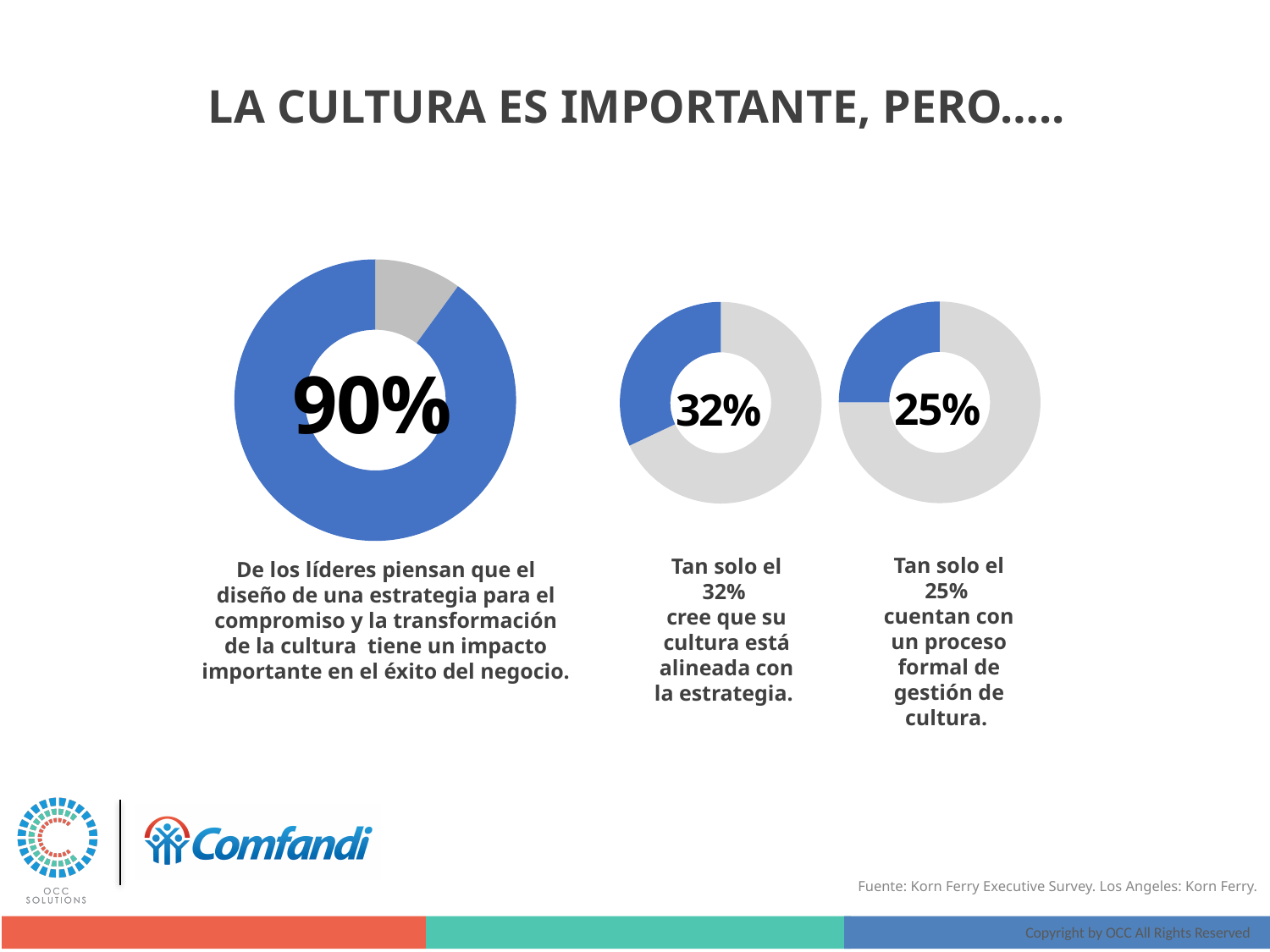
Which of the three donut charts shows the highest percentage? the left chart (90%) Which is larger: the percentage in the middle chart or the percentage in the right chart? the middle chart (32%) What is the difference between the percentage in the left chart (90%) and the percentage in the middle chart (32%)? 58 percentage points Which of the three donut charts shows the lowest percentage? the right chart (25%) What colour is used for the highlighted percentage slice in each donut chart? blue In the middle chart, what percentage believe their culture is aligned with the strategy? 32% In the left chart, what percentage of leaders think that designing a strategy for engagement and culture transformation has an important impact on business success? 90% What is the difference between the percentage in the middle chart (32%) and the percentage in the right chart (25%)? 7 percentage points In the left chart, what share of the donut is the grey (remaining) portion? 10% In the right chart, what percentage have a formal culture management process? 25% How many donut charts are shown on the slide? 3 What kind of chart is the left chart showing 90%? donut chart